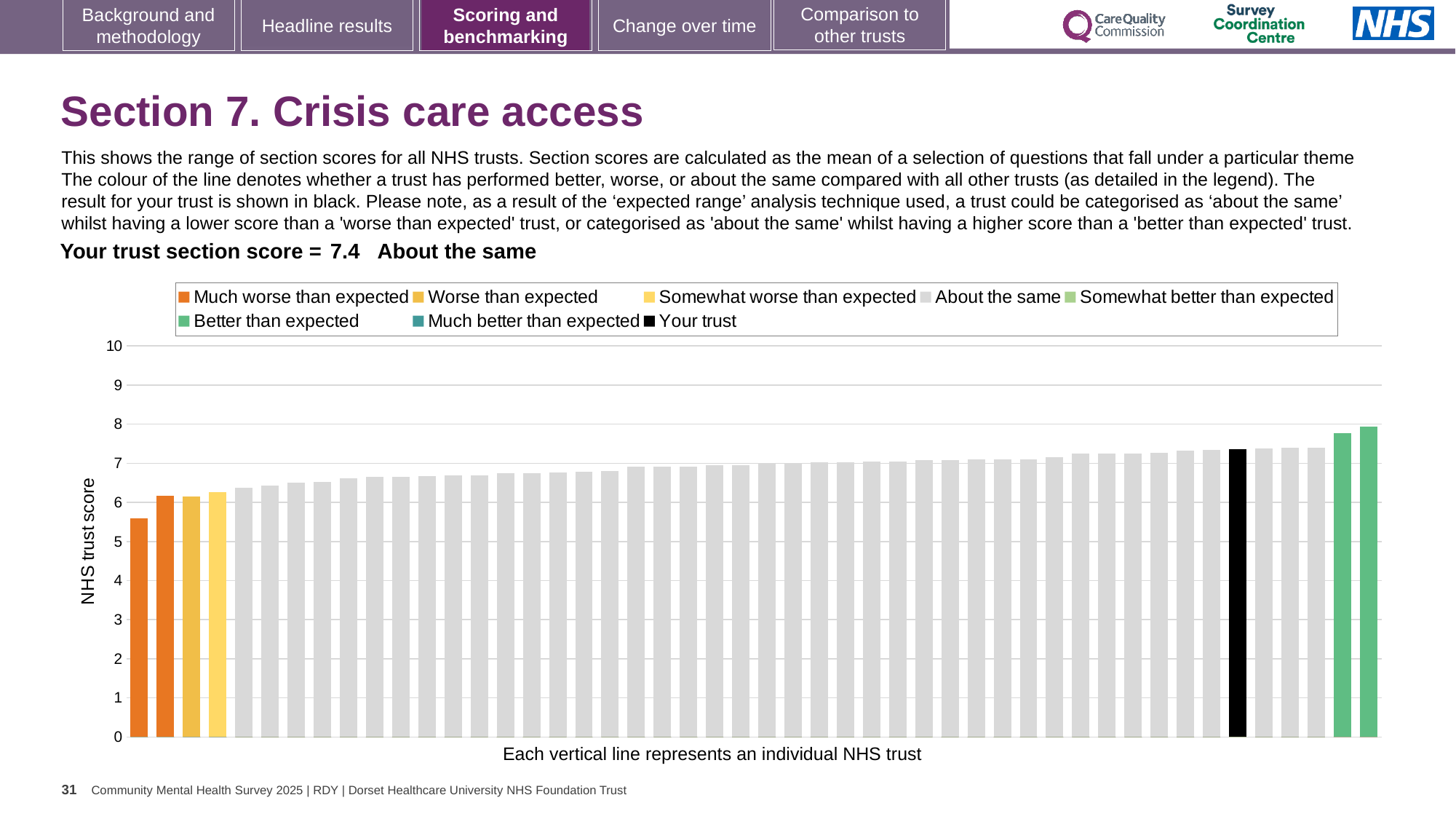
Is the value of the leftmost (lowest) bar greater or less than 6? less What is the label on the vertical axis of the chart? NHS trust score Which is larger: the black bar for your trust or the leftmost orange bar? the black bar for your trust Is the value of the rightmost (highest) bar greater or less than 7? greater How many bars are coloured orange (Much worse than expected)? 2 Do the bar values rise or fall from left to right across the chart? rise What does each vertical line in the chart represent, according to the caption below the chart? an individual NHS trust What is the section score for your trust shown on the slide? 7.4 How is your trust's section score categorised compared with other trusts? About the same What kind of chart is shown on the slide? bar chart How many entries does the chart legend list? 8 How many bars are coloured green (Better than expected)? 2